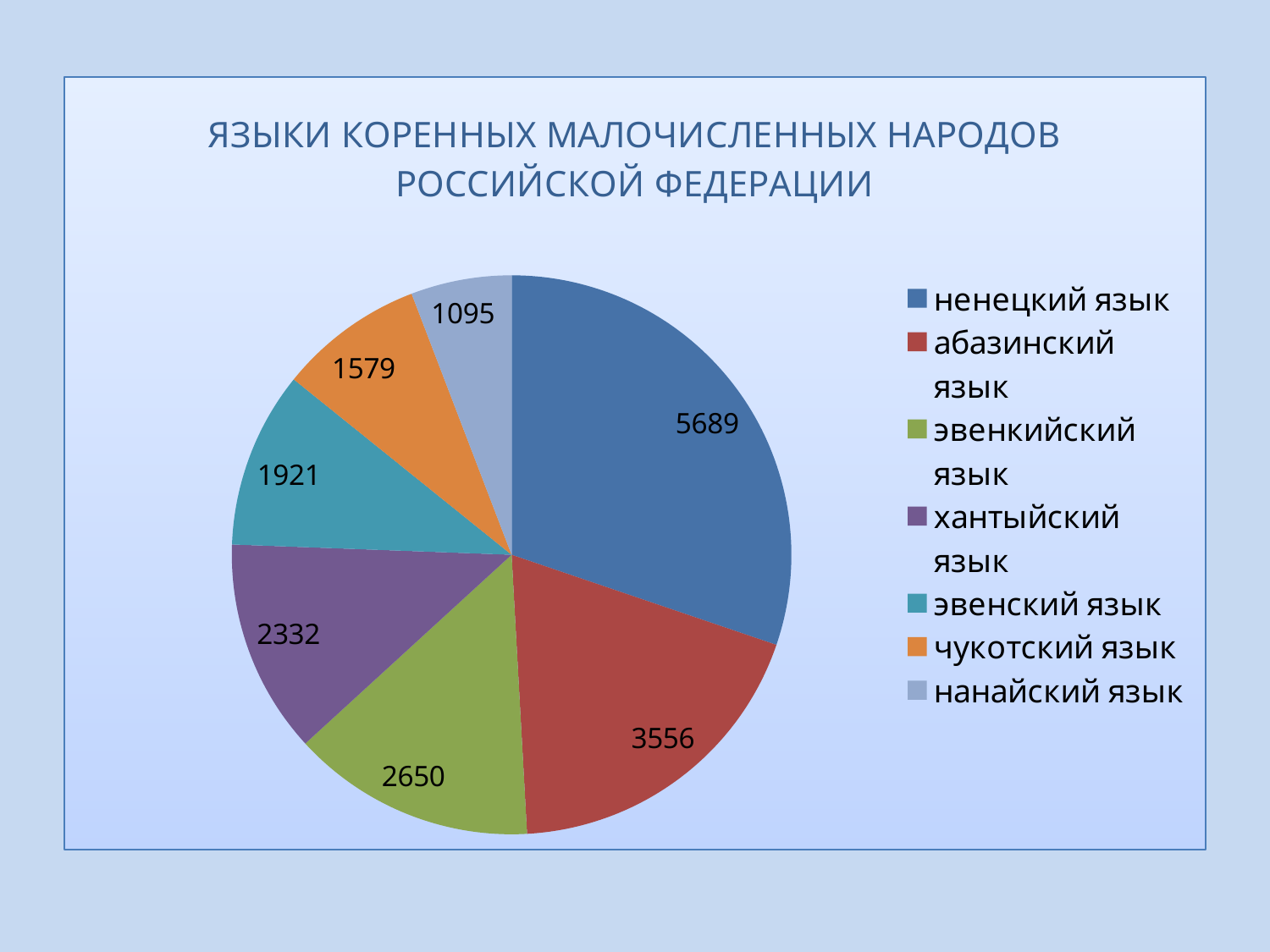
Which language has the smallest slice of the pie? нанайский язык How many languages are shown in the pie chart? 7 Which language has the largest slice of the pie? ненецкий язык What is the value for чукотский язык? 1579 Which is larger, the value for эвенский язык or the value for чукотский язык? эвенский язык What is the difference between the values for ненецкий язык and абазинский язык? 2133 What is the total of all the values shown in the pie chart? 18822 What is the value for ненецкий язык? 5689 What is the title of the chart? ЯЗЫКИ КОРЕННЫХ МАЛОЧИСЛЕННЫХ НАРОДОВ РОССИЙСКОЙ ФЕДЕРАЦИИ What is the value for хантыйский язык? 2332 What is the difference between the values for эвенкийский язык and хантыйский язык? 318 What kind of chart is shown on the slide? pie chart